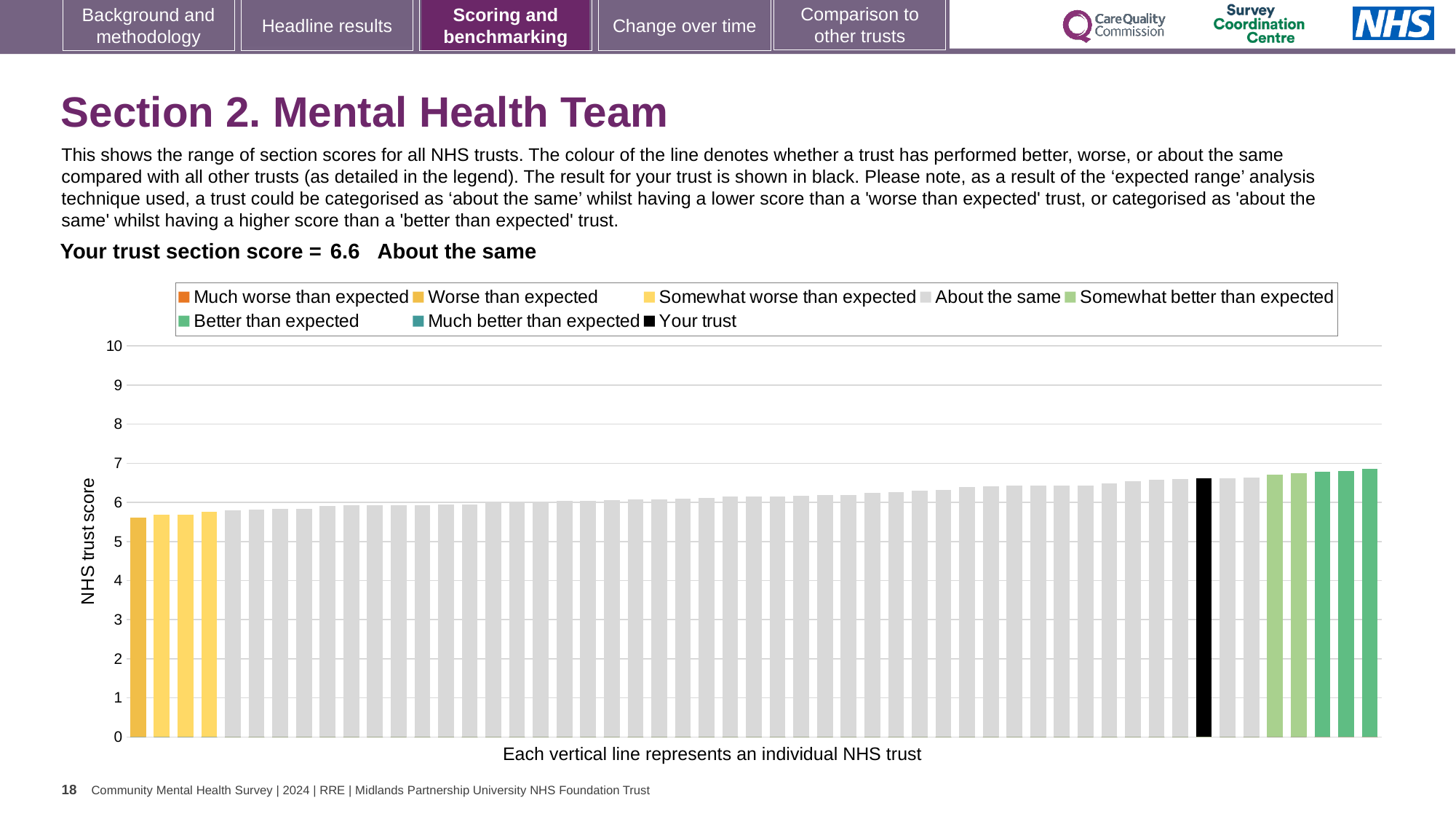
Is the value of the leftmost bar greater or less than 5? greater Is the value of the rightmost bar greater or less than 7? less According to the slide, which category does your trust's section score fall into? About the same How many entries does the chart legend list? 8 Which is larger, the rightmost bar or the black bar for your trust? the rightmost bar Is the value for your trust (the black bar) greater or less than 7? less Which is larger, the leftmost bar or the black bar for your trust? the black bar for your trust What is the section score for your trust shown on the slide? 6.6 What is the label on the vertical axis of the chart? NHS trust score Do the bar values rise or fall moving from left to right along the x axis? rise What kind of chart is shown on the slide? bar chart